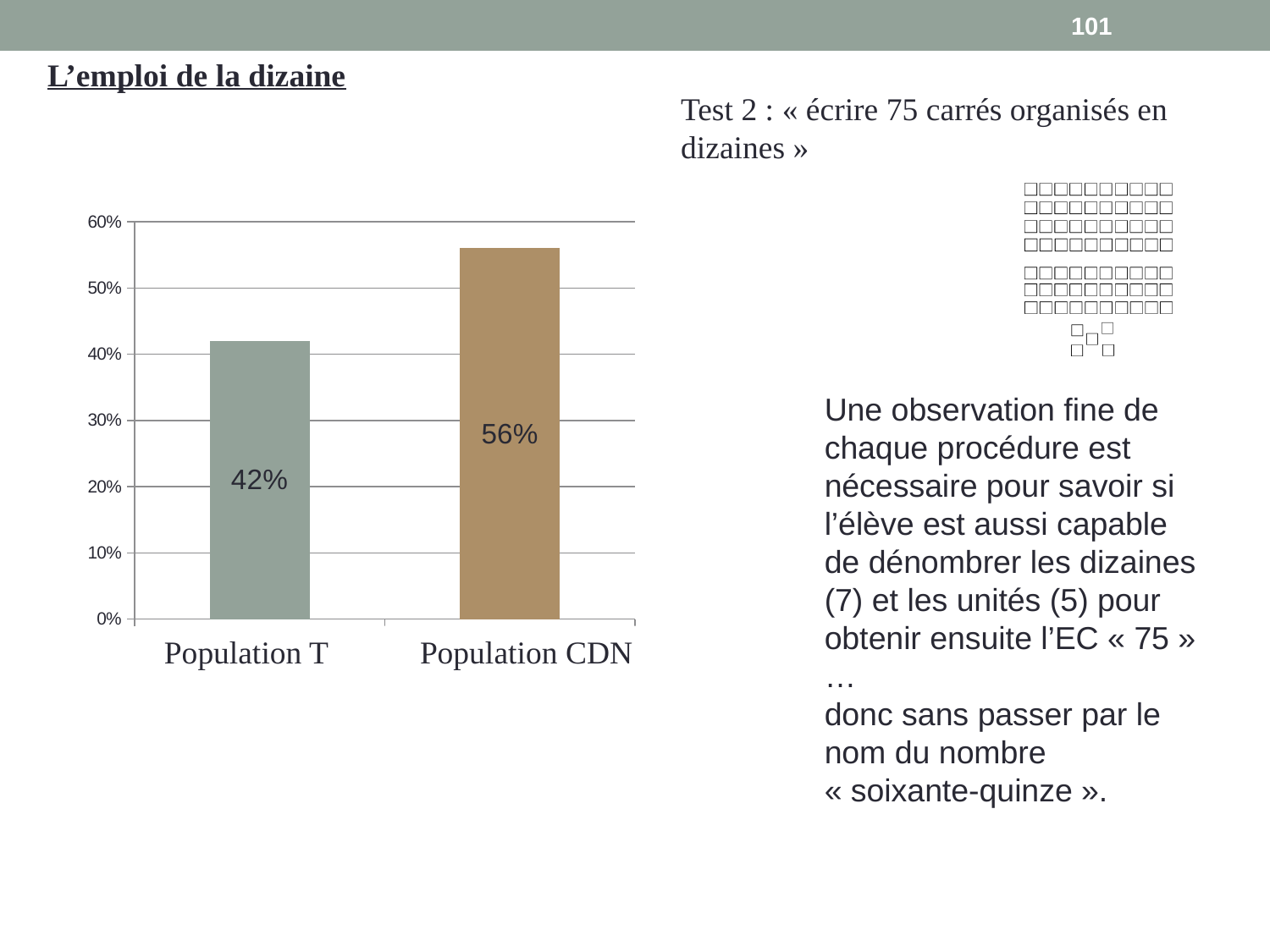
What colour is the bar for Population CDN? brown Which category has the lowest value? Population T How many categories are shown on the x axis of the chart? 2 Is the value for Population CDN greater or less than 50%? greater Which category has the highest value? Population CDN What is the highest value shown on the y axis of the chart? 60% What is the value for Population CDN? 56% What kind of chart is shown on the slide? bar chart What is the difference between the values for Population CDN and Population T? 14% Which is larger, the value for Population T or the value for Population CDN? Population CDN Is the value for Population T greater or less than 50%? less What is the value for Population T? 42%